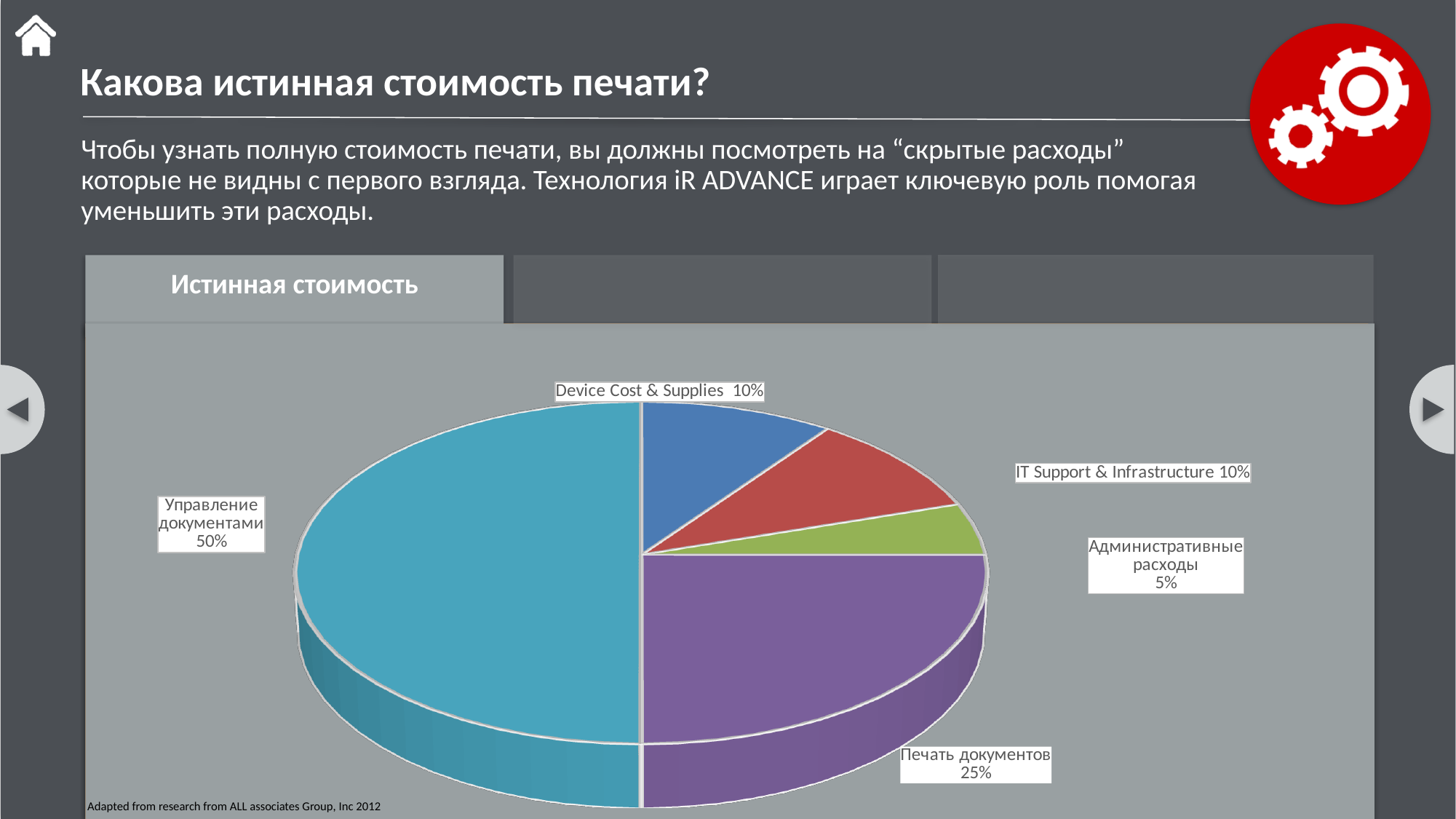
What share of the pie does Управление документами take? 50% Which is larger, the share for Печать документов or the share for IT Support & Infrastructure? Печать документов What is the value shown for Печать документов? 25% Which category has the smallest share of the pie? Административные расходы What is the value shown for Административные расходы? 5% What is the difference between the shares of Управление документами and Печать документов? 25% What is the value shown for Device Cost & Supplies? 10% How many slices does the pie chart have? 5 What is the source note printed below the chart? Adapted from research from ALL associates Group, Inc 2012 What is the value shown for IT Support & Infrastructure? 10% What kind of chart is shown on the slide? pie chart Which category has the largest share of the pie? Управление документами